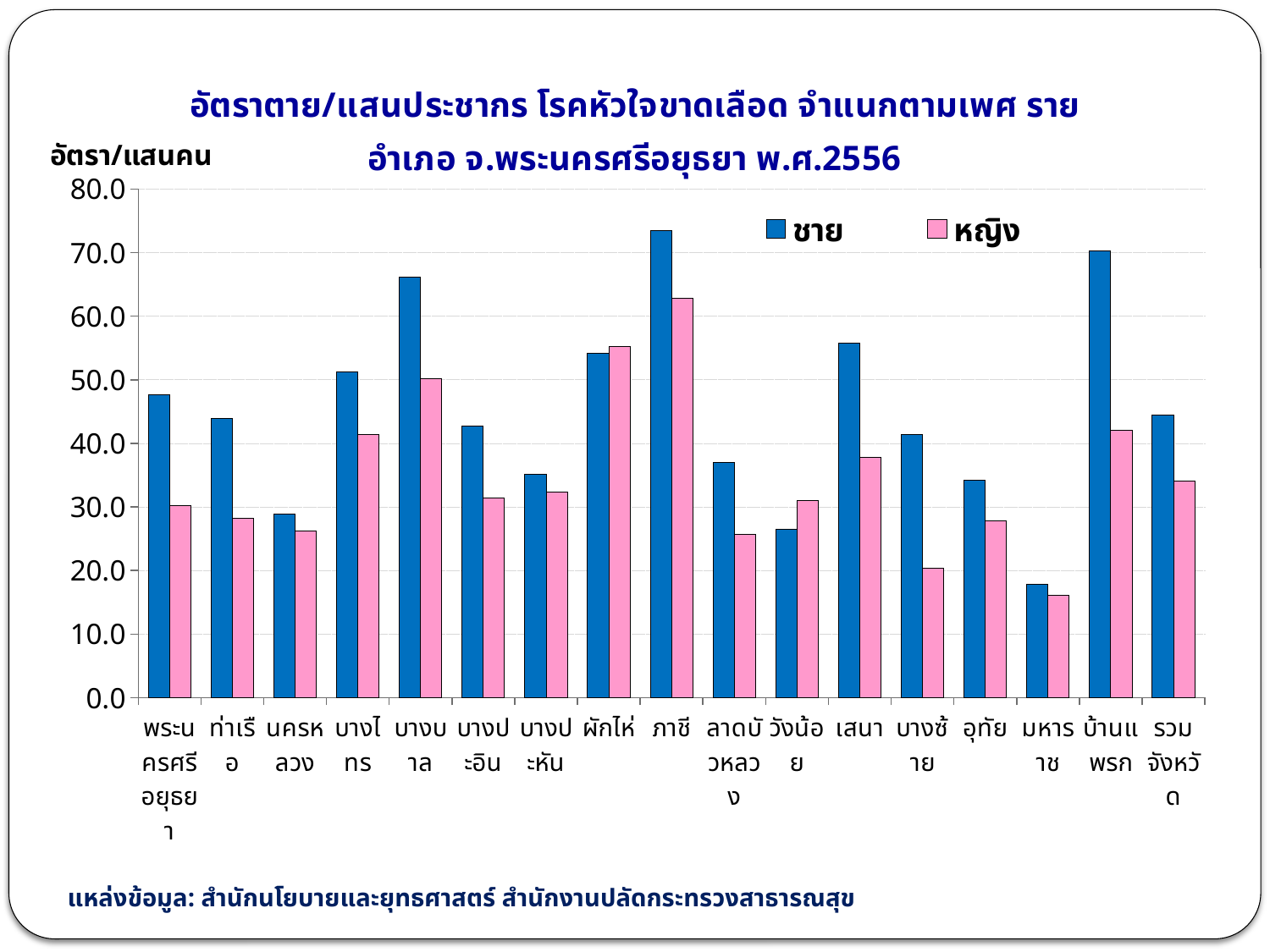
Is the value for ชาย in ภาชี greater or less than 70.0? greater Is the value for ชาย in รวมจังหวัด greater or less than 40.0? greater Which category has the highest value for หญิง? ภาชี Which colour represents the series หญิง in the legend? pink Which category has the highest value for ชาย? ภาชี Is the value for หญิง in รวมจังหวัด greater or less than 40.0? less How many districts (categories) are shown on the x axis, including รวมจังหวัด? 17 Which category has the lowest value for ชาย? มหาราช In วังน้อย, which is larger, the value for ชาย or for หญิง? หญิง How many series does the legend list? 2 What kind of chart is shown on the slide? bar chart